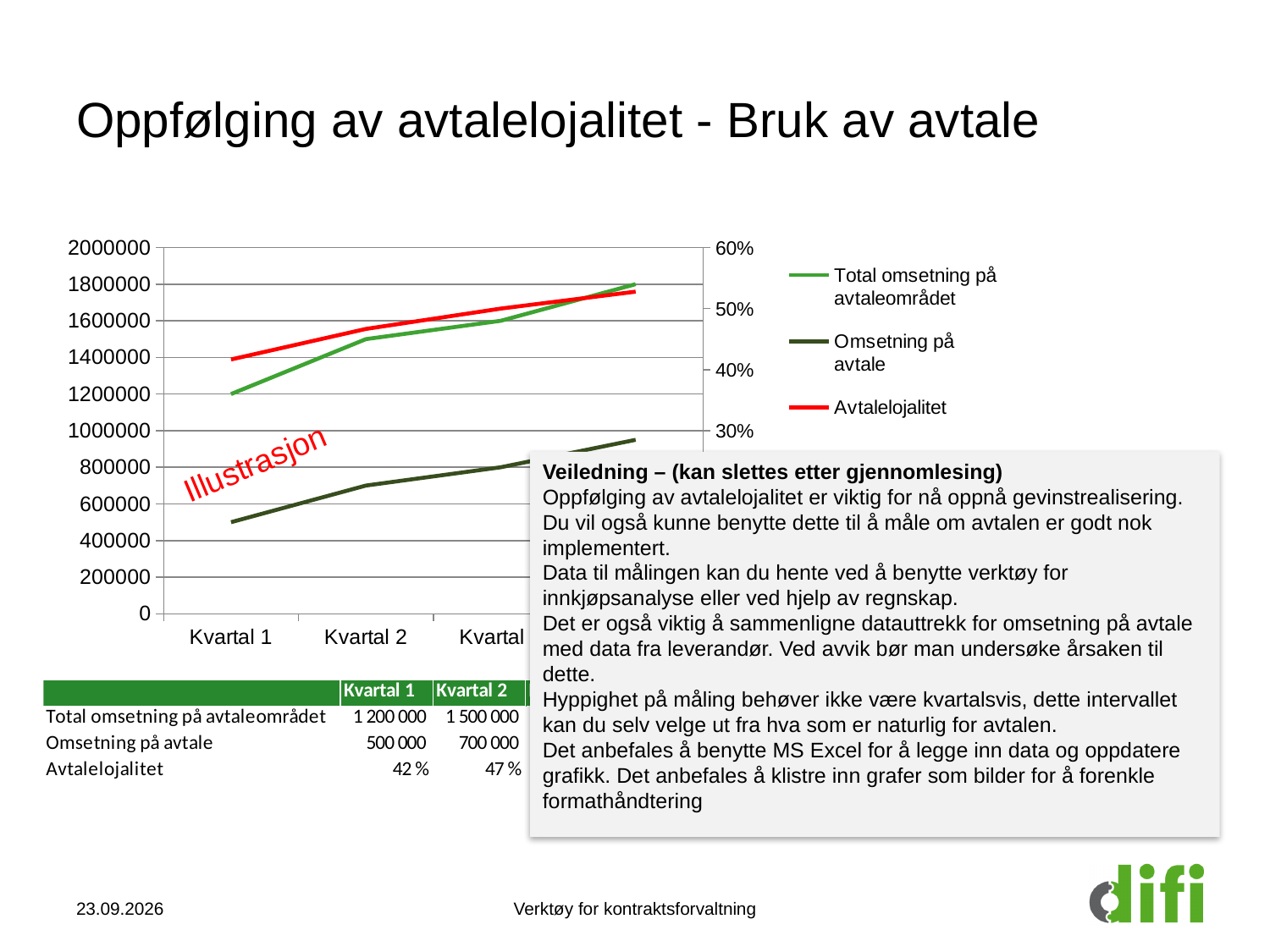
How many series does the chart legend list? 3 Which colour is used for the Avtalelojalitet line? Red By how much did Total omsetning på avtaleområdet increase from Kvartal 1 to Kvartal 2? 300 000 What is the value of Omsetning på avtale in Kvartal 2? 700 000 What is the Avtalelojalitet value in Kvartal 1? 42 % What is the value of Total omsetning på avtaleområdet in Kvartal 1? 1 200 000 What is the Avtalelojalitet value in Kvartal 2? 47 % What kind of chart is shown on the slide? Line chart What is the difference between Total omsetning på avtaleområdet and Omsetning på avtale in Kvartal 1? 700 000 What is the value of Total omsetning på avtaleområdet in Kvartal 2? 1 500 000 Does the Omsetning på avtale line rise or fall across the quarters? Rises Is the value of Omsetning på avtale in Kvartal 1 greater or less than 600000? less